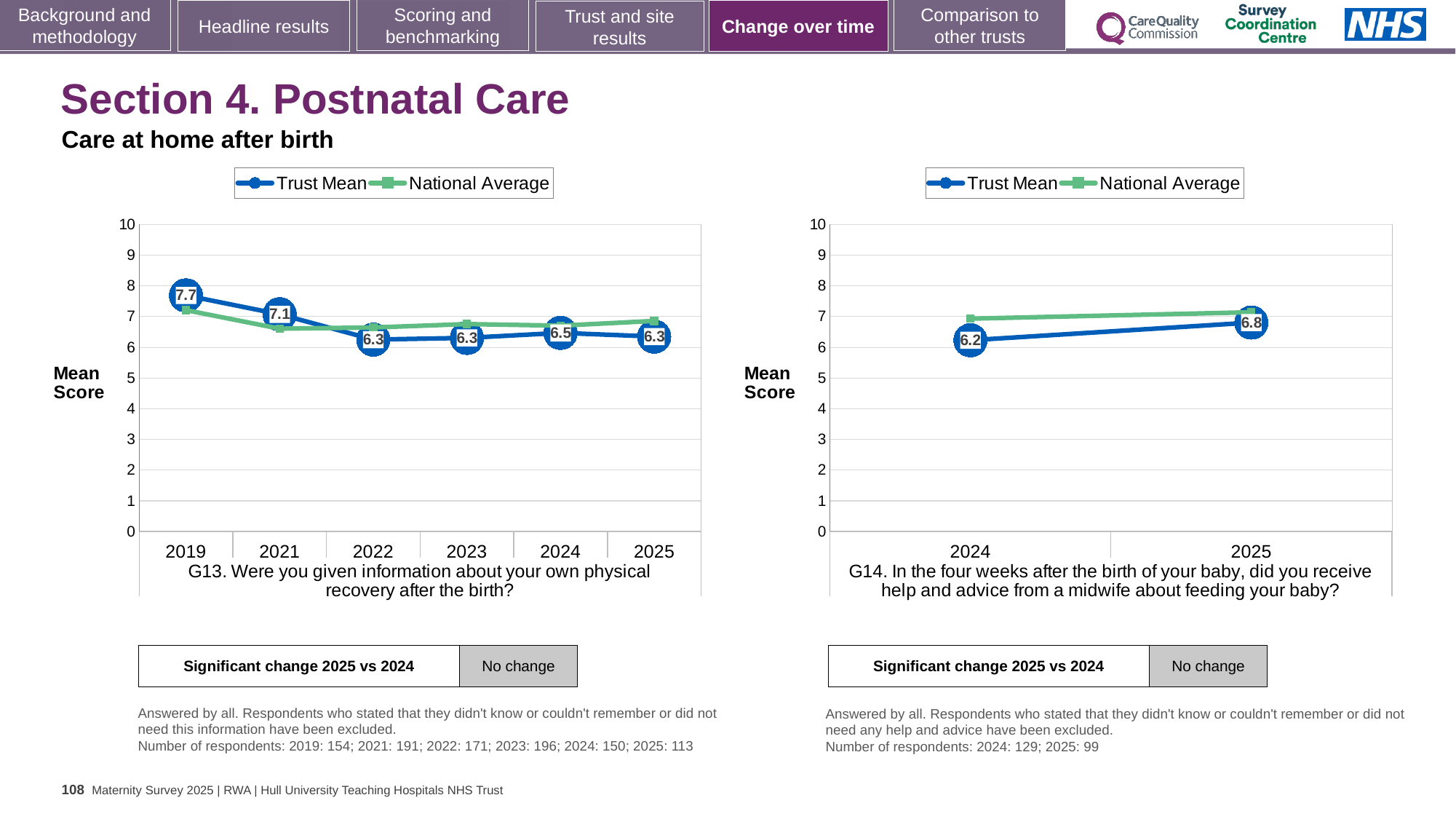
How many series does the legend of the G14 chart on the right list? 2 In the G13 chart on the left, is the Trust Mean score for 2024 higher or lower than for 2025? higher In the G13 chart on the left, is the National Average for 2019 greater or less than 8? less In the G13 chart on the left, what is the difference between the Trust Mean scores for 2019 and 2021? 0.6 How many years are plotted on the x axis of the G13 chart on the left? 6 In the G14 chart on the right, what is the Trust Mean score for 2025? 6.8 In the G13 chart on the left, what is the Trust Mean score for 2019? 7.7 What type of chart is the G14 chart on the right? Line chart In the G14 chart on the right, by how much did the Trust Mean score change from 2024 to 2025? 0.6 In the G13 chart on the left, which year has the highest Trust Mean score? 2019 In the G13 chart on the left, what is the Trust Mean score for 2024? 6.5 In the G14 chart on the right, which year has the lower Trust Mean score? 2024